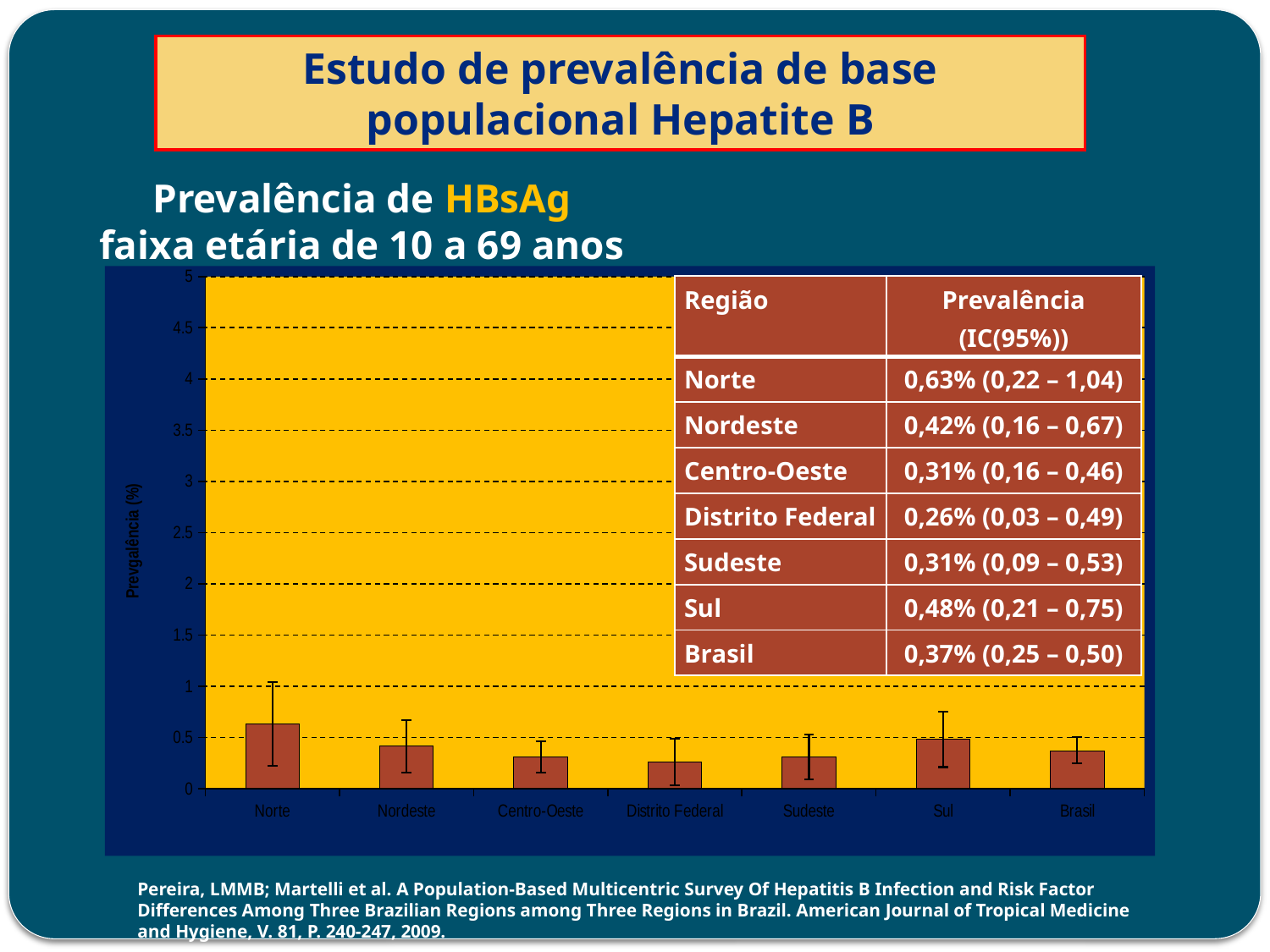
What is the prevalence value shown for Norte? 0,63% What kind of chart is shown on the slide? Bar chart How many regions (bars) are shown in the chart? 7 What is the prevalence value shown for Sul? 0,48% What is the label of the vertical axis of the chart? Prevgalência (%) Which has a higher prevalence, Sul or Nordeste? Sul What is the prevalence value shown for Brasil? 0,37% Which region has the highest prevalence in the chart? Norte Which region has the lowest prevalence in the chart? Distrito Federal What is the difference between the prevalence for Norte and for Nordeste? 0,21 percentage points Is the value for Norte greater or less than 0.5? greater What is the prevalence value shown for Distrito Federal? 0,26%